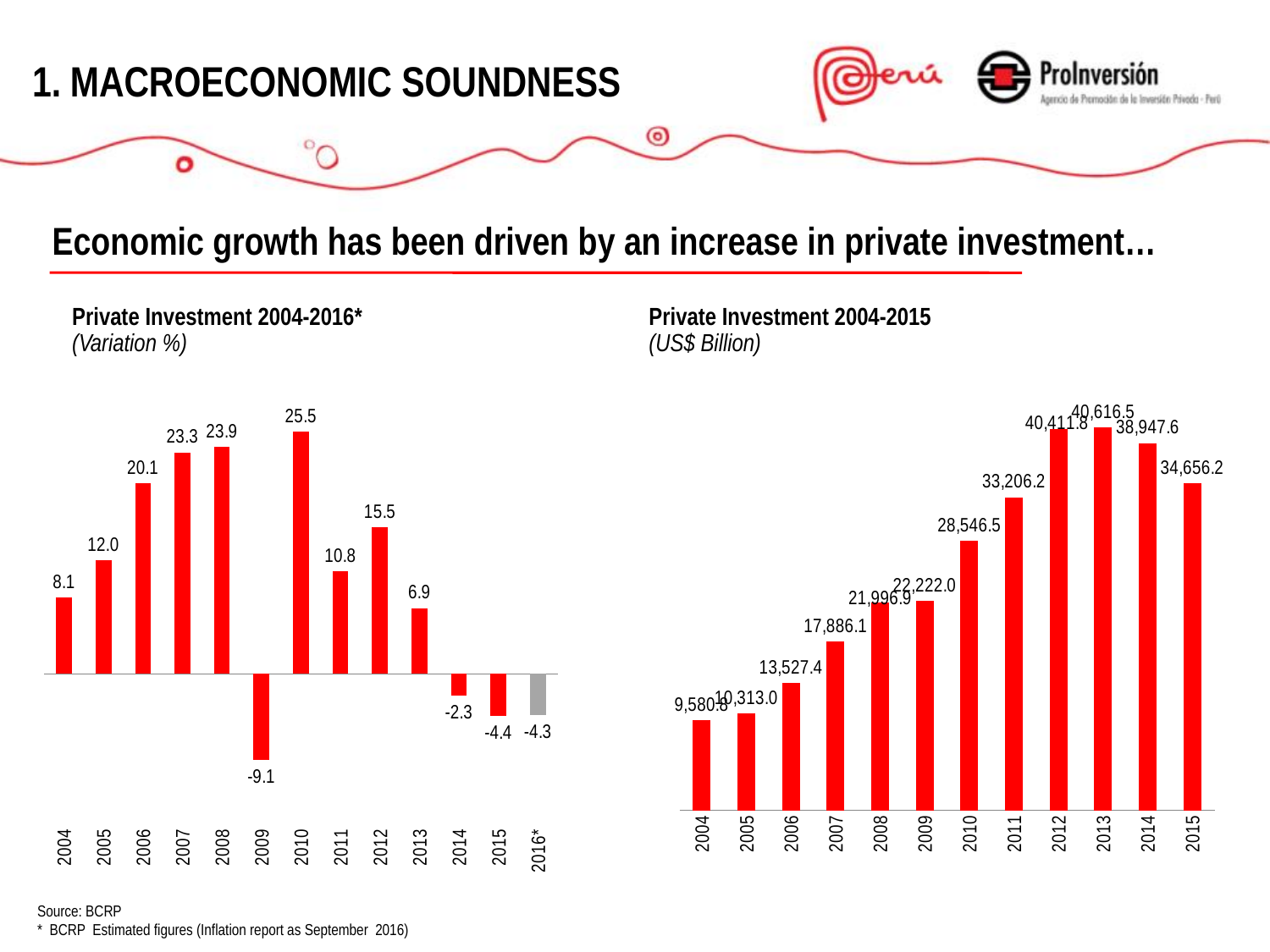
In the 'Private Investment 2004-2016*' chart, which year has the highest variation %? 2010 In the 'Private Investment 2004-2015' chart, which year has the lowest value? 2004 In the 'Private Investment 2004-2015' chart, what is the difference between the 2010 value and the 2009 value? 6,324.5 In the 'Private Investment 2004-2016*' chart, how many years are shown on the x axis? 13 In the 'Private Investment 2004-2016*' chart, which year has the lowest variation %? 2009 In the 'Private Investment 2004-2015' chart, which is larger, the value for 2014 or the value for 2015? 2014 In the 'Private Investment 2004-2016*' chart, what is the difference between the 2012 value and the 2013 value? 8.6 In the 'Private Investment 2004-2016*' chart, what is the variation % for 2010? 25.5 In the 'Private Investment 2004-2016*' chart, what is the variation % for 2009? -9.1 In the 'Private Investment 2004-2015' chart, what is the value for 2011? 33,206.2 In the 'Private Investment 2004-2015' chart, what is the value for 2015? 34,656.2 What kind of chart is the 'Private Investment 2004-2015' chart? Bar chart